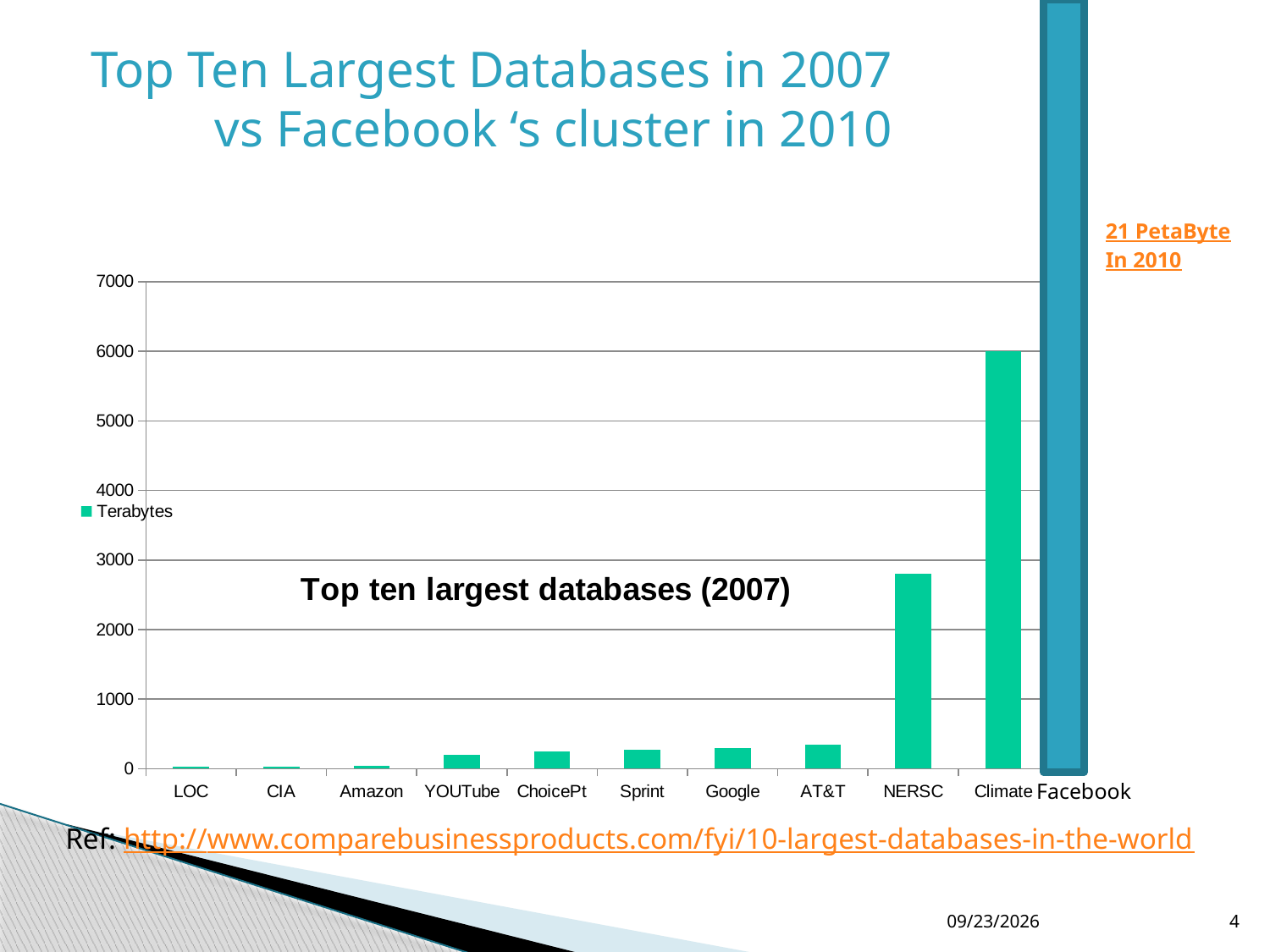
How many database categories are plotted on the x axis of the chart (not counting the separate Facebook annotation)? 10 Which has a larger value, NERSC or AT&T? NERSC Do the bar values generally rise or fall from left to right along the x axis? rise How many series does the chart's legend list? 1 Which database has the highest value in the chart? Climate What is the name of the series shown in the chart's legend? Terabytes Is the value for Google greater or less than 1000? less Is the value for Climate greater or less than 5000? greater What kind of chart is shown on the slide? bar chart Is the value for NERSC greater or less than 2000? greater Which has a larger value, Climate or NERSC? Climate